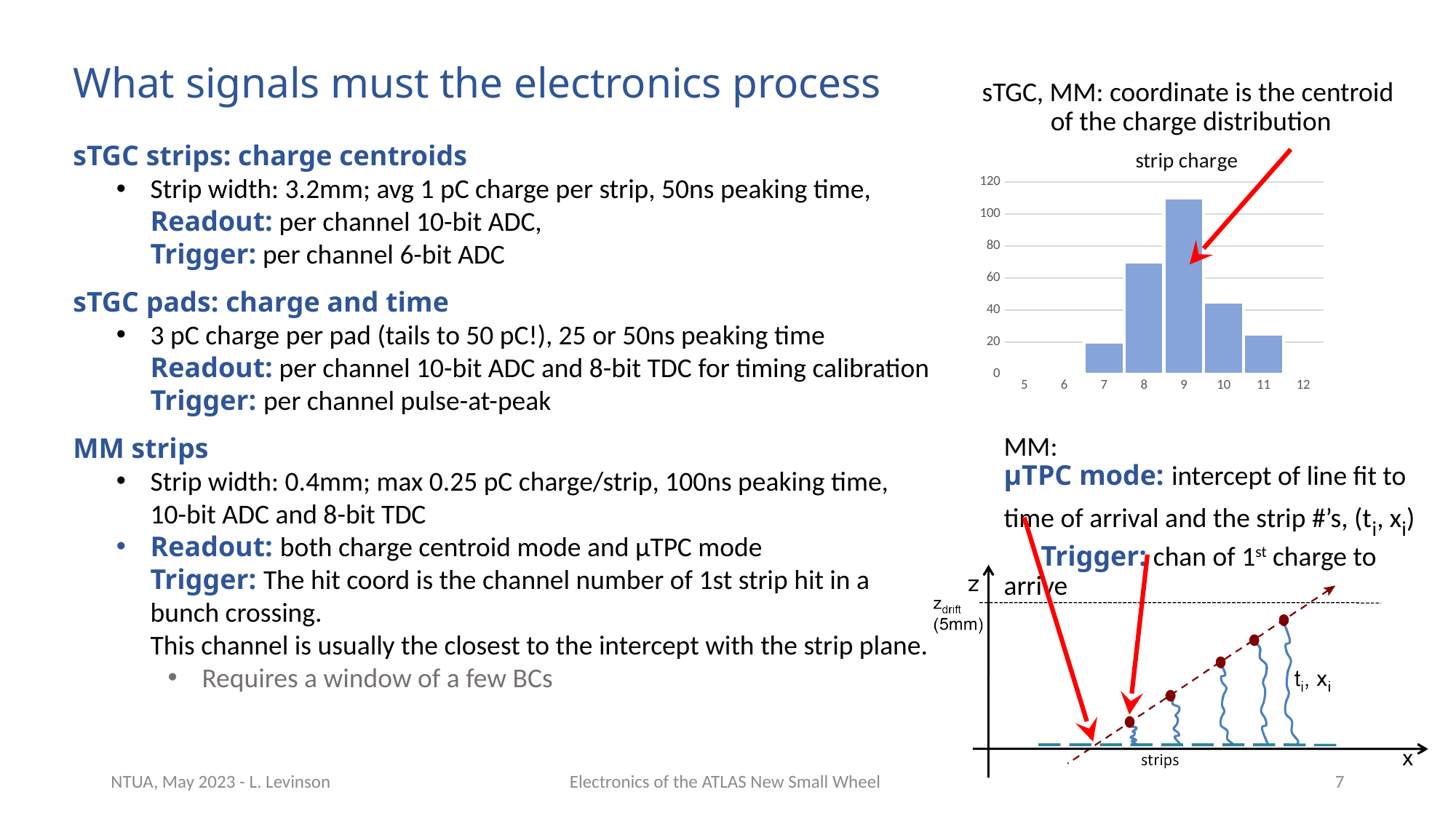
What is the title of the bar chart on the slide? strip charge In the "strip charge" chart, is the value for strip 10 greater or less than 60? less In the "strip charge" chart, which strip number has the highest charge? 9 What kind of chart is the "strip charge" chart? bar chart In the "strip charge" chart, which is larger, the value for strip 8 or the value for strip 10? strip 8 How many bars are plotted in the "strip charge" chart? 5 In the "strip charge" chart, is the value for strip 11 greater or less than 40? less In the "strip charge" chart, is the value for strip 9 greater or less than 100? greater In the "strip charge" chart, which is larger, the value for strip 11 or the value for strip 7? strip 11 In the "strip charge" chart, which of the plotted bars is the lowest? 7